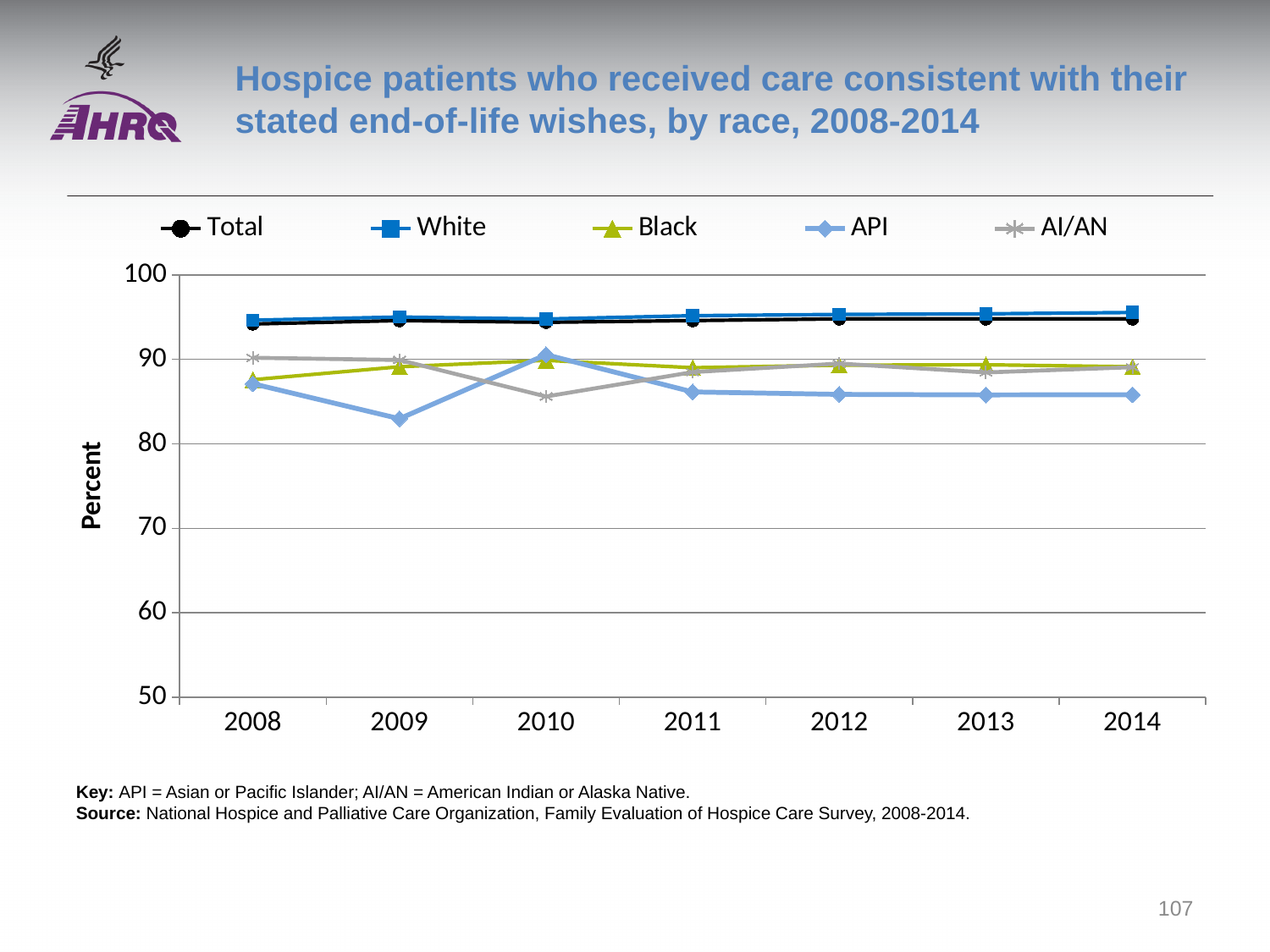
What is the label on the y axis? Percent What kind of chart is shown on the slide? Line chart Which series has the lowest value in 2009? API How many years are plotted along the x axis? 7 How many series does the legend list? 5 In 2009, which is larger, the value for White or the value for API? White Is the value for API in 2009 greater or less than 90? less Is the value for API in 2009 greater or less than 80? greater In which year is the API series at its lowest? 2009 Is the value for White in 2014 greater or less than 90? greater Which series has the lowest value in 2010? AI/AN